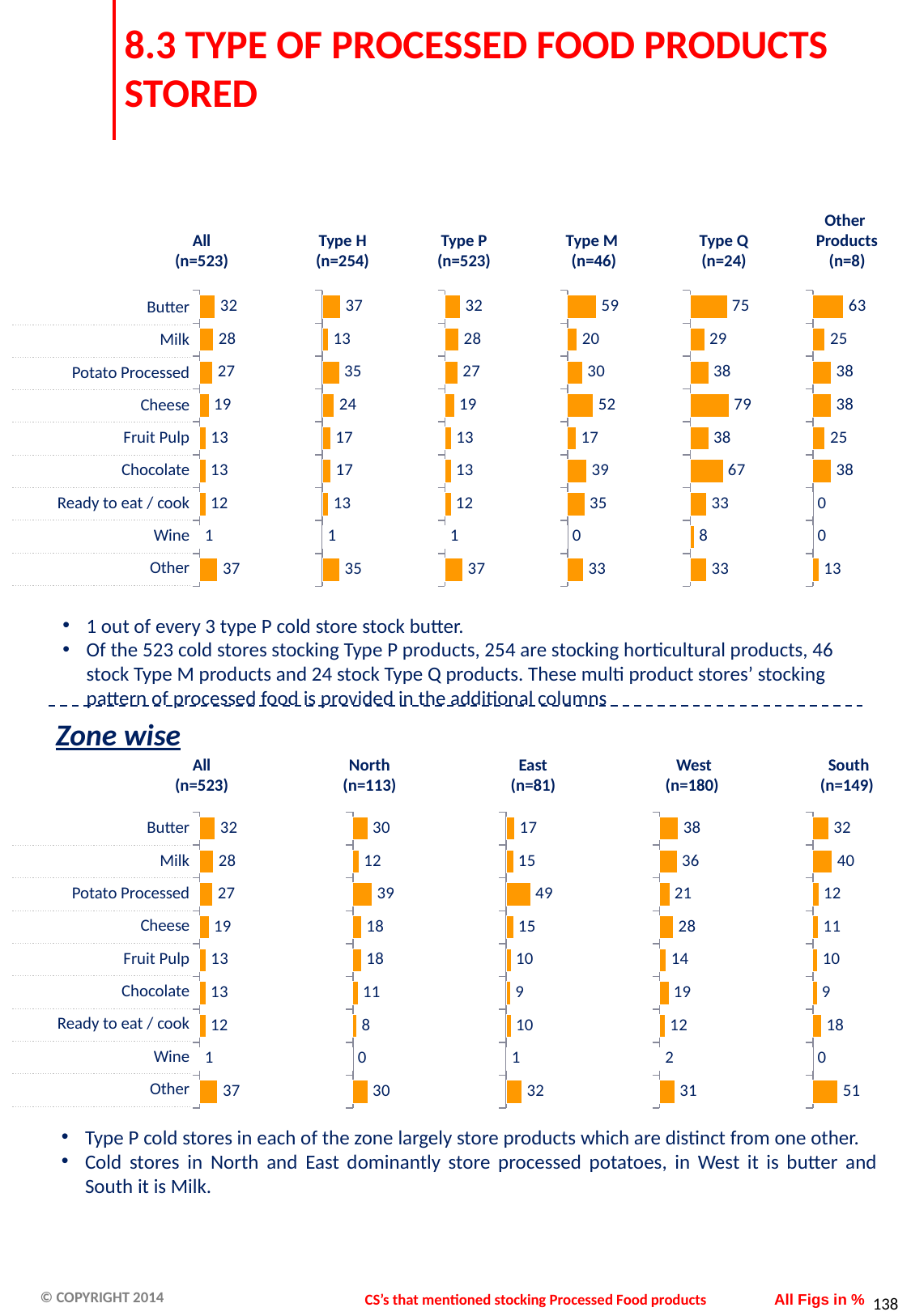
In the top section, in the Type Q (n=24) chart, what is the value for Cheese? 79 In the top section, in the Other Products (n=8) chart, what is the value for Butter? 63 What kind of chart is used for the Zone wise North (n=113) data? Bar chart In the Zone wise section, in the East (n=81) chart, what is the value for Potato Processed? 49 In the Zone wise section, in the East (n=81) chart, what is the difference between the values for Potato Processed and Butter? 32 What is the sample size shown for the West chart in the Zone wise section? n=180 How many product categories are listed in the All (n=523) chart in the top section? 9 In the Zone wise section, in the West (n=180) chart, which is larger: Butter or Milk? Butter In the Zone wise section, in the South (n=149) chart, which category has the highest value? Other In the top section, in the Type M (n=46) chart, which category has the highest value? Butter In the top section, in the Type Q (n=24) chart, what is the difference between the values for Cheese and Butter? 4 In the Zone wise section, in the North (n=113) chart, which category has the lowest value? Wine